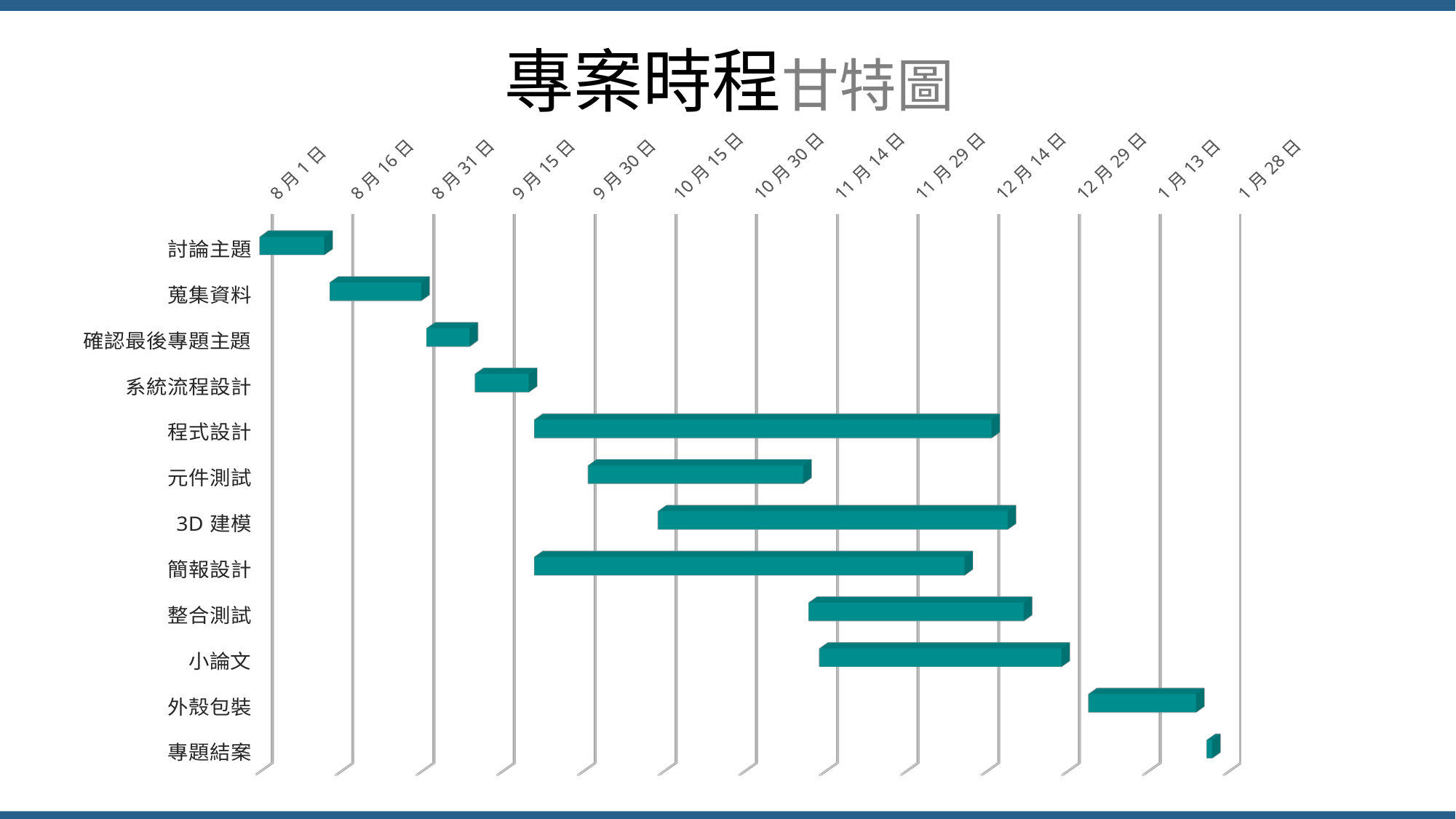
Which bar is longer, 程式設計 or 元件測試? 程式設計 What is the first date label on the horizontal axis? 8月1日 What kind of chart is shown on the slide? Bar chart (Gantt chart) Which task's bar ends latest on the timeline? 專題結案 Does the bar for 元件測試 end before or after the 11月14日 gridline? before Which bar is longer, 3D 建模 or 系統流程設計? 3D 建模 What is the last date label on the horizontal axis? 1月28日 How many tasks are listed on the vertical axis of the chart? 12 Which task has the shortest bar in the chart? 專題結案 Which task has the longest bar in the chart? 程式設計 Does the bar for 整合測試 start before or after the 10月30日 gridline? after